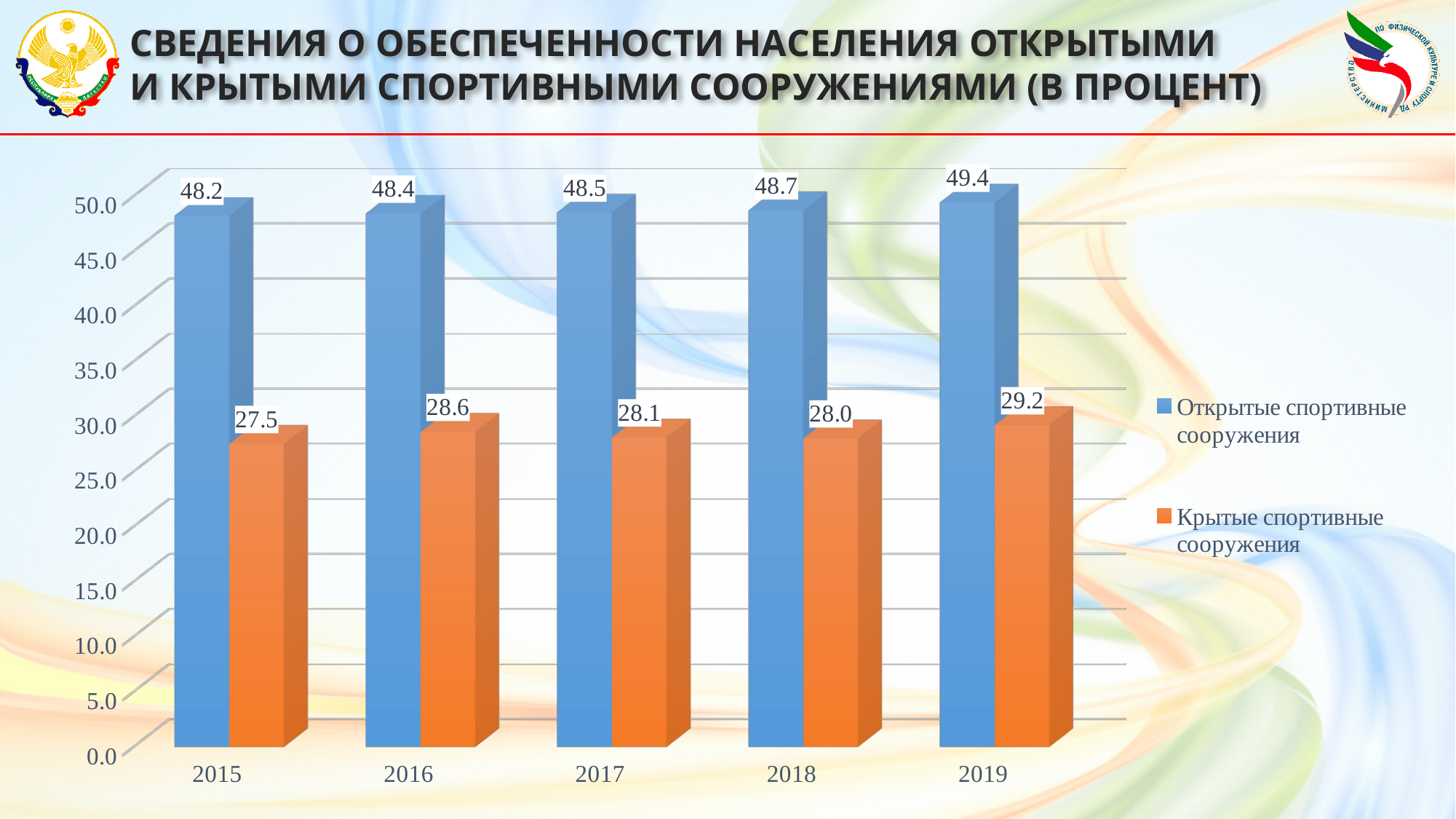
Which is larger in 2016: Открытые спортивные сооружения or Крытые спортивные сооружения? Открытые спортивные сооружения What is the value for Крытые спортивные сооружения in 2015? 27.5 What is the value for Крытые спортивные сооружения in 2018? 28.0 Do the values for Открытые спортивные сооружения rise or fall from 2015 to 2019? rise How many series does the legend list? 2 In which year is the value for Открытые спортивные сооружения highest? 2019 In which year is the value for Крытые спортивные сооружения lowest? 2015 How many years are shown on the x axis? 5 What is the difference between Открытые спортивные сооружения and Крытые спортивные сооружения in 2017? 20.4 What is the value for Открытые спортивные сооружения in 2019? 49.4 What kind of chart is shown on the slide? bar chart Is the value for Крытые спортивные сооружения in 2019 greater or less than 25.0? greater